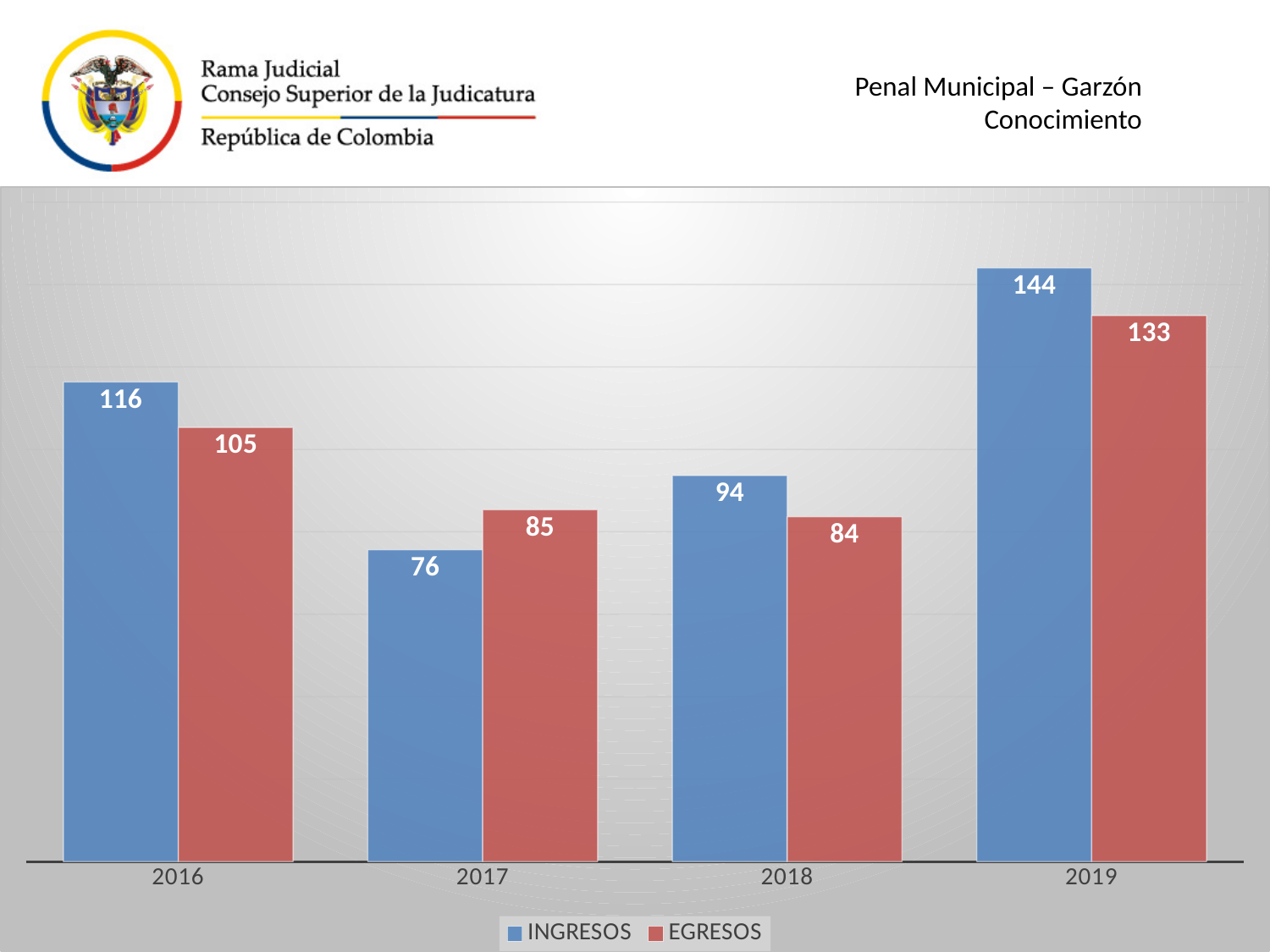
Which year has the highest INGRESOS value? 2019 Which series is shown in red? EGRESOS Which year has the lowest EGRESOS value? 2018 What is the EGRESOS value for 2019? 133 How many series does the legend list? 2 What is the EGRESOS value for 2018? 84 What is the difference between INGRESOS and EGRESOS in 2019? 11 What is the INGRESOS value for 2016? 116 What kind of chart is shown on the slide? Bar chart What is the difference between INGRESOS in 2016 and INGRESOS in 2017? 40 How many years are shown on the x axis? 4 Which is larger in 2017, INGRESOS or EGRESOS? EGRESOS